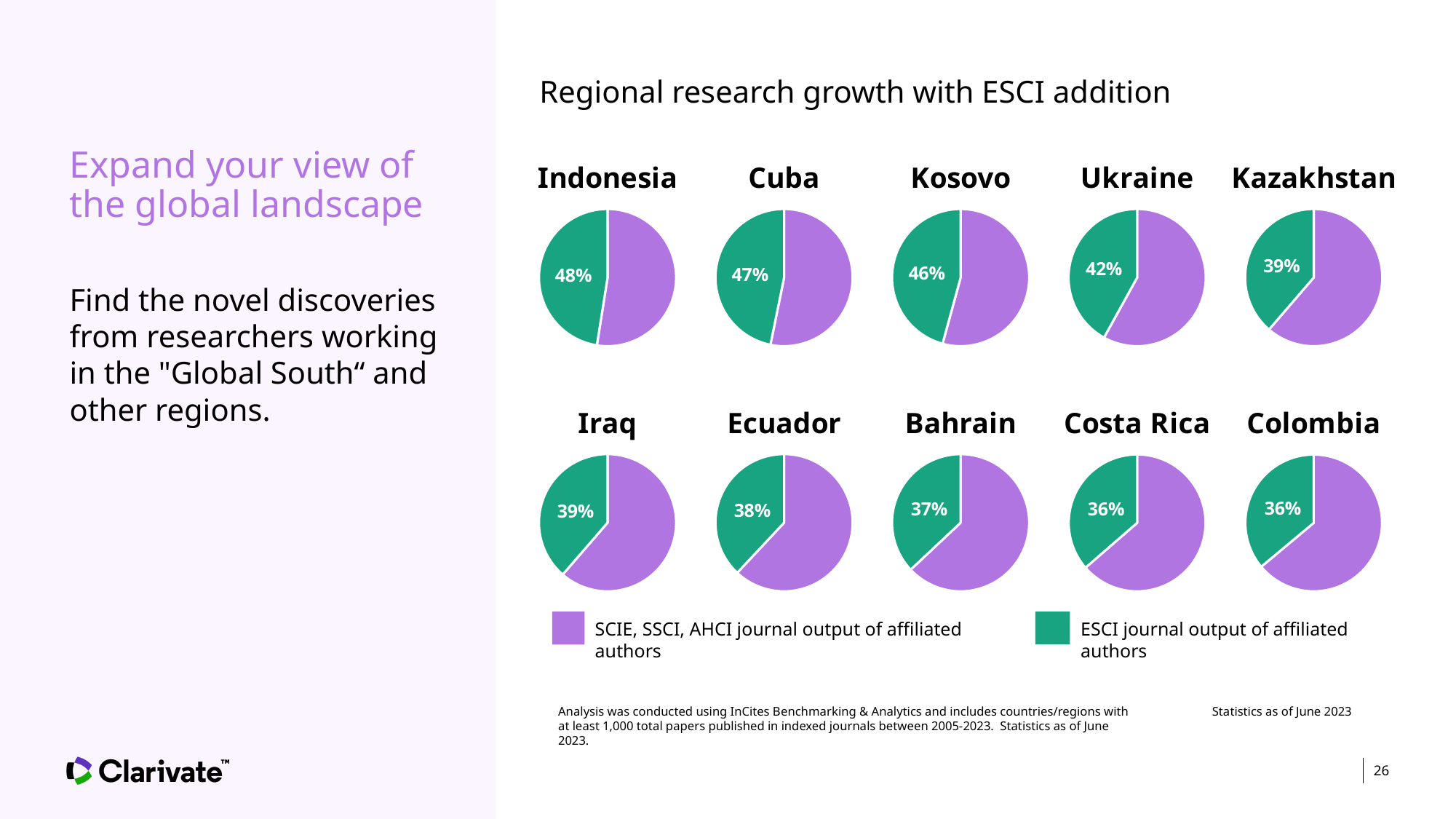
What type of chart is used to show the regional research growth with ESCI addition? Pie chart Which has a larger ESCI journal output share, the Cuba pie chart or the Ecuador pie chart? Cuba Across the ten pie charts, which countries have the lowest ESCI journal output share? Costa Rica and Colombia In the Costa Rica pie chart, what share is the ESCI journal output of affiliated authors? 36% Across the ten pie charts, which country has the highest ESCI journal output share? Indonesia How many entries does the legend below the pie charts list? 2 In the Indonesia pie chart, what share is the ESCI journal output of affiliated authors? 48% Which colour represents the ESCI journal output of affiliated authors in the pie charts? Green What is the difference between the ESCI share in the Indonesia pie chart and the ESCI share in the Ukraine pie chart? 6 percentage points In the Kazakhstan pie chart, what percentage is labelled on the green ESCI slice? 39% How many pie charts are shown on the slide? 10 In the Bahrain pie chart, what share of the pie is the SCIE, SSCI, AHCI journal output of affiliated authors? 63%